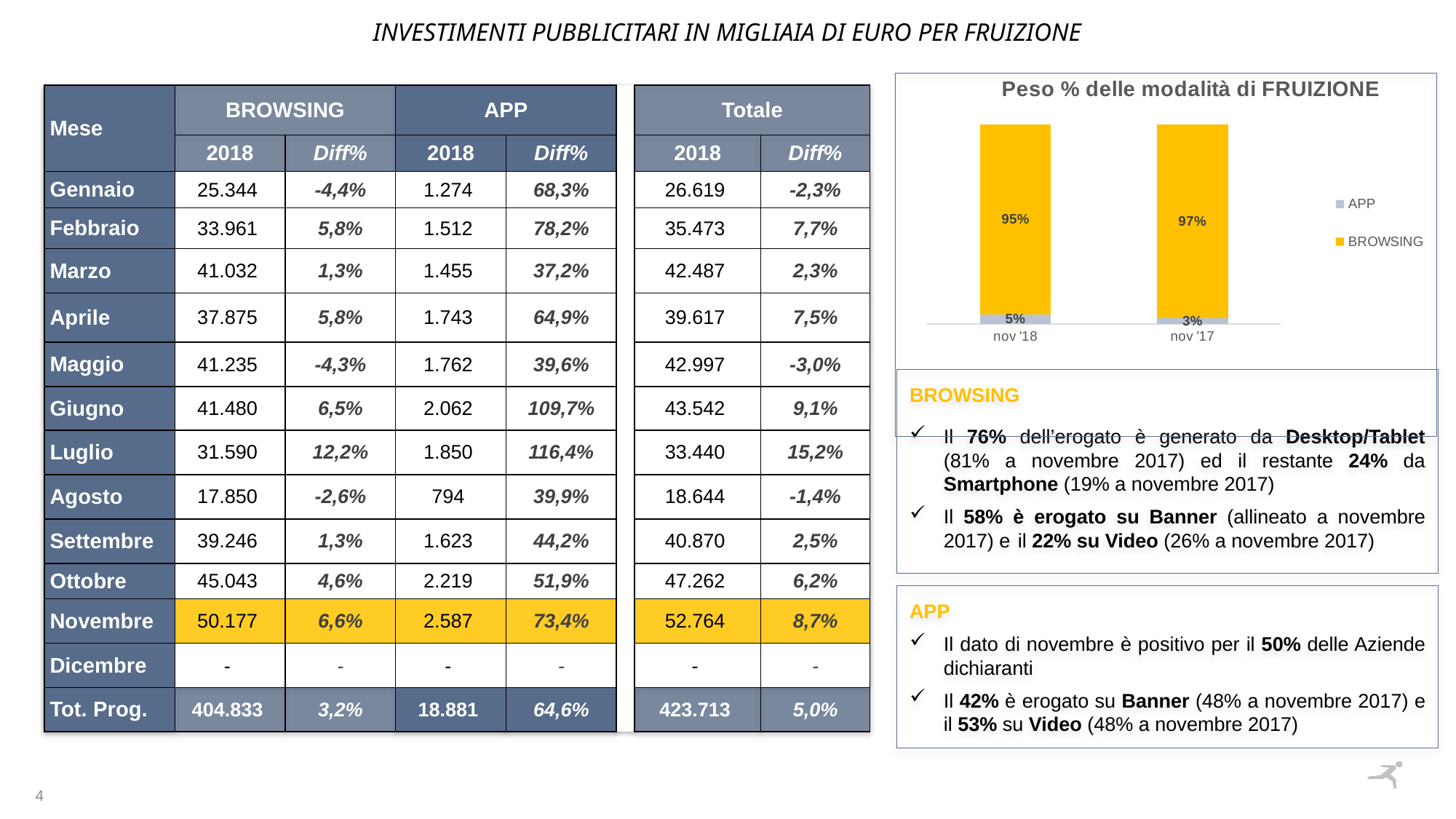
In the chart "Peso % delle modalità di FRUIZIONE", which colour represents BROWSING? yellow How many series does the legend of the chart "Peso % delle modalità di FRUIZIONE" list? 2 What kind of chart is "Peso % delle modalità di FRUIZIONE"? stacked bar chart In the chart "Peso % delle modalità di FRUIZIONE", what is the APP share for nov '18? 5% In the chart "Peso % delle modalità di FRUIZIONE", what is the total of the stacked bar for nov '18? 100% In the chart "Peso % delle modalità di FRUIZIONE", which period has the higher BROWSING share? nov '17 In the chart "Peso % delle modalità di FRUIZIONE", which period has the higher APP share, nov '18 or nov '17? nov '18 How many categories are shown on the x axis of the chart "Peso % delle modalità di FRUIZIONE"? 2 In the chart "Peso % delle modalità di FRUIZIONE", what is the BROWSING share for nov '18? 95% In the chart "Peso % delle modalità di FRUIZIONE", what is the difference between the BROWSING share in nov '17 and in nov '18? 2% In the chart "Peso % delle modalità di FRUIZIONE", what is the APP share for nov '17? 3% In the chart "Peso % delle modalità di FRUIZIONE", what is the BROWSING share for nov '17? 97%